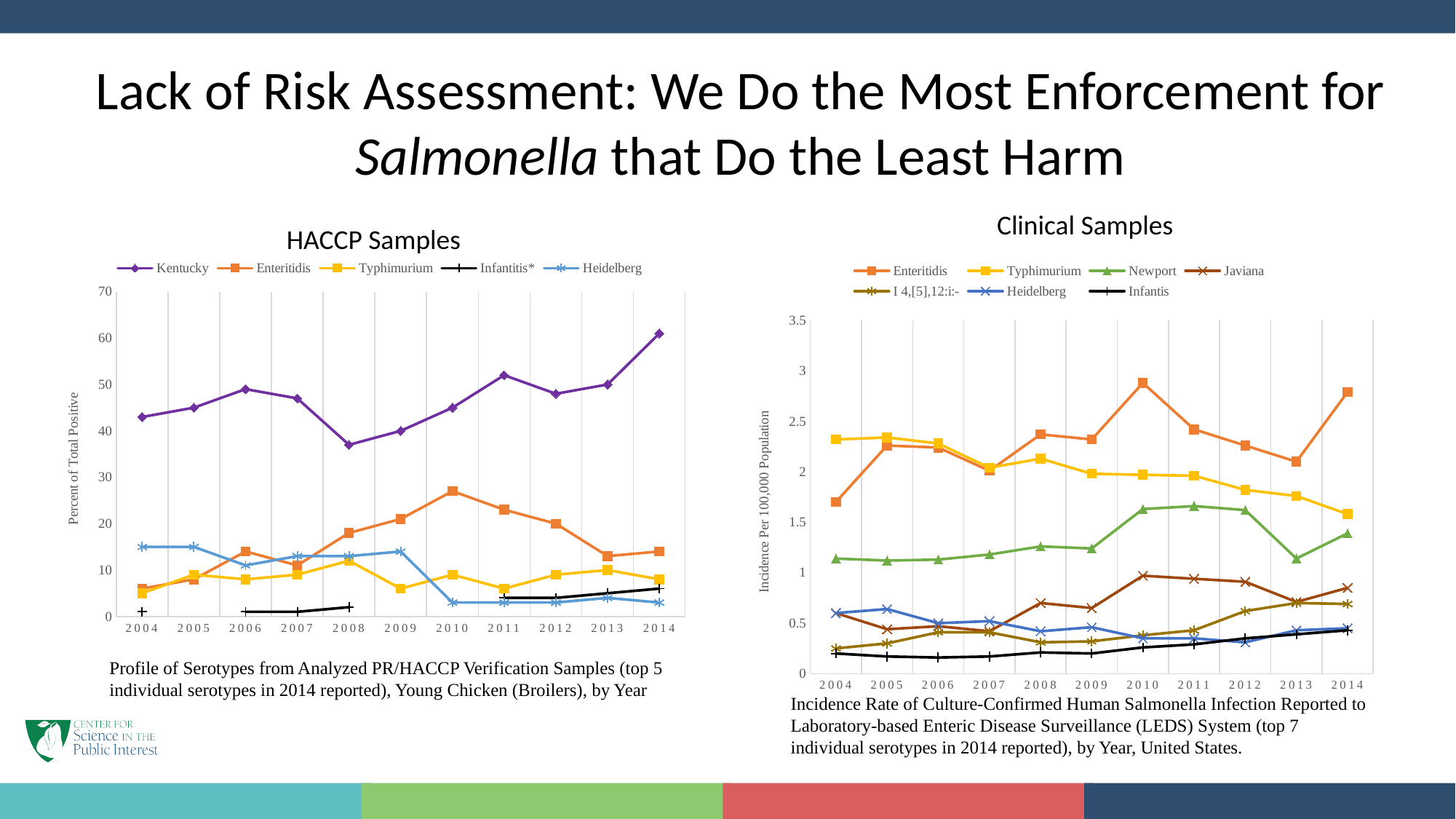
How many series does the legend of the HACCP Samples chart list? 5 What is the y-axis label of the Clinical Samples chart? Incidence Per 100,000 Population In the HACCP Samples chart, is the value for Enteritidis in 2010 greater or less than 20? greater How many series does the legend of the Clinical Samples chart list? 7 In the HACCP Samples chart, which serotype has the highest value in 2014? Kentucky In the Clinical Samples chart, which is larger in 2014, Enteritidis or Typhimurium? Enteritidis How many years are shown on the x axis of the Clinical Samples chart? 11 In the HACCP Samples chart, is the value for Kentucky in 2008 greater or less than 40? less What kind of chart is the HACCP Samples chart? line chart In the Clinical Samples chart, is the value for Enteritidis in 2010 greater or less than 2.5? greater In the Clinical Samples chart, which serotype has the lowest incidence in 2004? Infantis